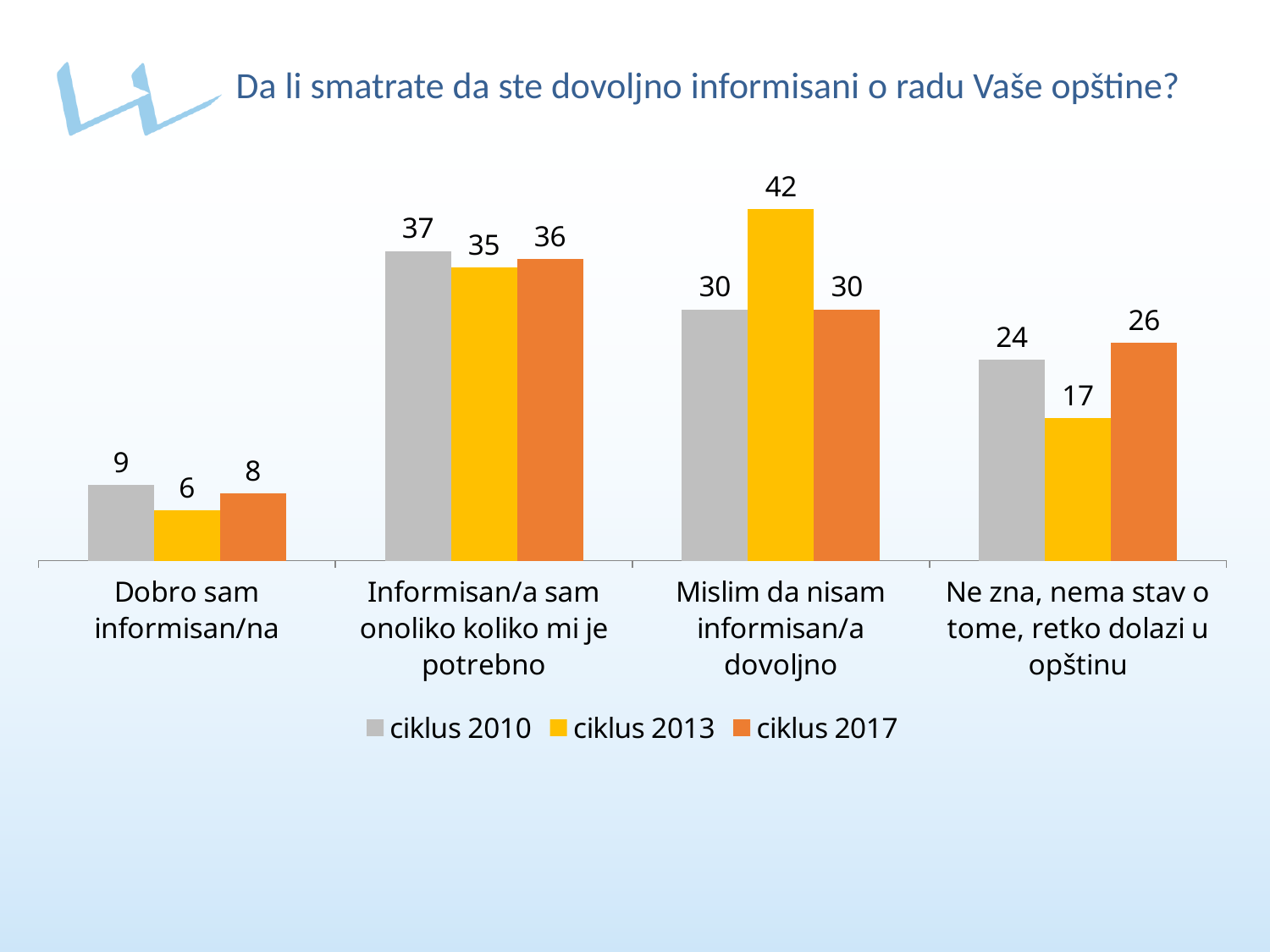
How many categories are shown on the x axis? 4 What is the value for 'Ne zna, nema stav o tome, retko dolazi u opštinu' in the ciklus 2017 series? 26 What is the difference between the ciklus 2013 and ciklus 2010 values for 'Mislim da nisam informisan/a dovoljno'? 12 Which category has the lowest value in the ciklus 2017 series? Dobro sam informisan/na What is the value for 'Dobro sam informisan/na' in the ciklus 2010 series? 9 What is the value for 'Informisan/a sam onoliko koliko mi je potrebno' in the ciklus 2013 series? 35 Which category has the highest value in the ciklus 2013 series? Mislim da nisam informisan/a dovoljno Which is larger for 'Ne zna, nema stav o tome, retko dolazi u opštinu': the ciklus 2010 value or the ciklus 2013 value? ciklus 2010 How many series does the legend list? 3 What is the value for 'Mislim da nisam informisan/a dovoljno' in the ciklus 2013 series? 42 What kind of chart is shown on the slide? bar chart What is the title of the chart? Da li smatrate da ste dovoljno informisani o radu Vaše opštine?